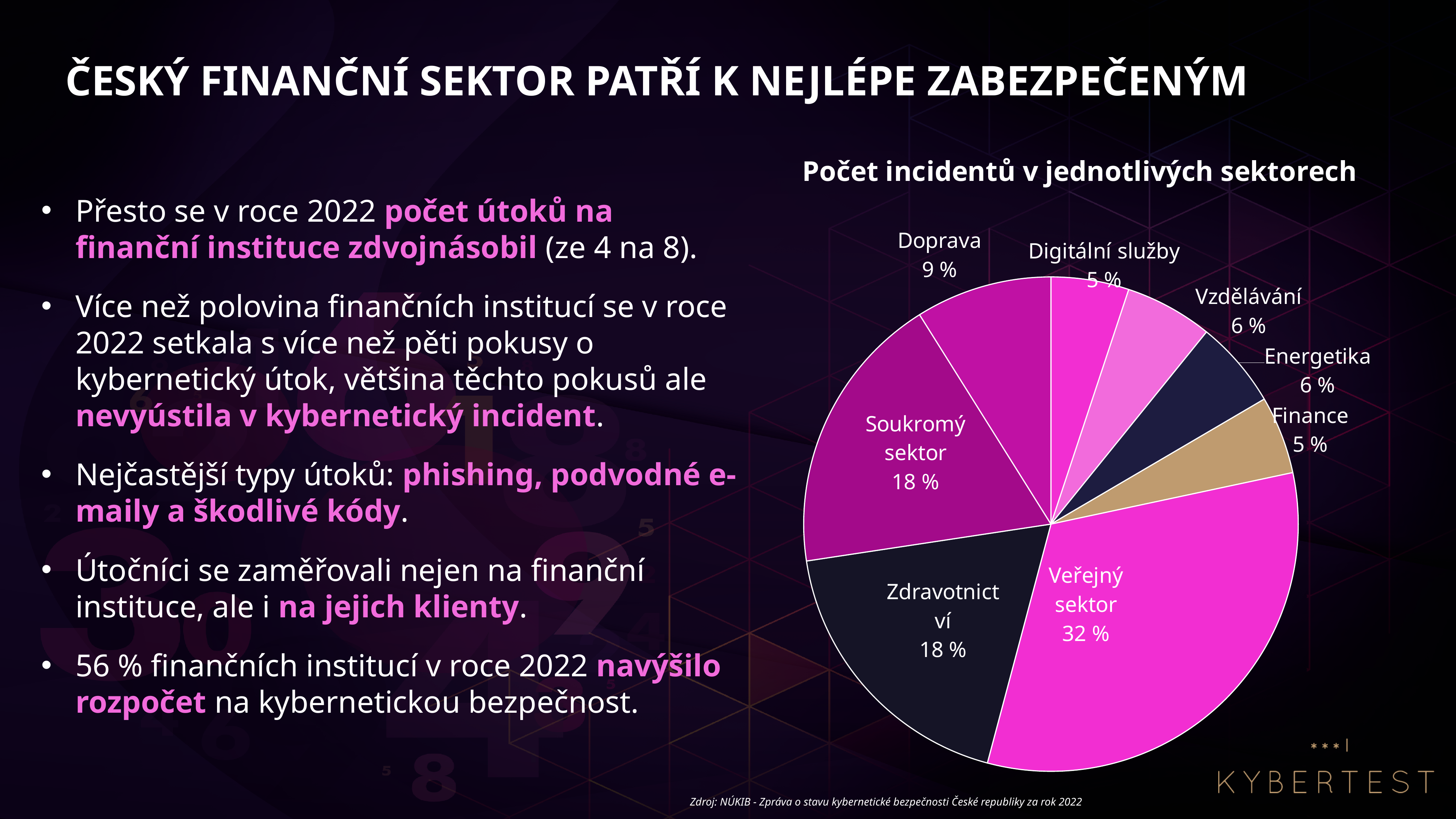
What is the value shown for Energetika? 6 % How many sectors (slices) does the pie chart show? 8 Which sector has the largest share of incidents? Veřejný sektor What is the value shown for Soukromý sektor? 18 % What is the value shown for Zdravotnictví? 18 % What kind of chart is shown on the slide? pie chart What is the title of the chart? Počet incidentů v jednotlivých sektorech What is the value shown for Doprava? 9 % Which is larger, the share for Doprava or the share for Vzdělávání? Doprava What is the difference in percentage points between Veřejný sektor and Zdravotnictví? 14 What share of incidents does Veřejný sektor account for? 32 % What is the value shown for Finance? 5 %